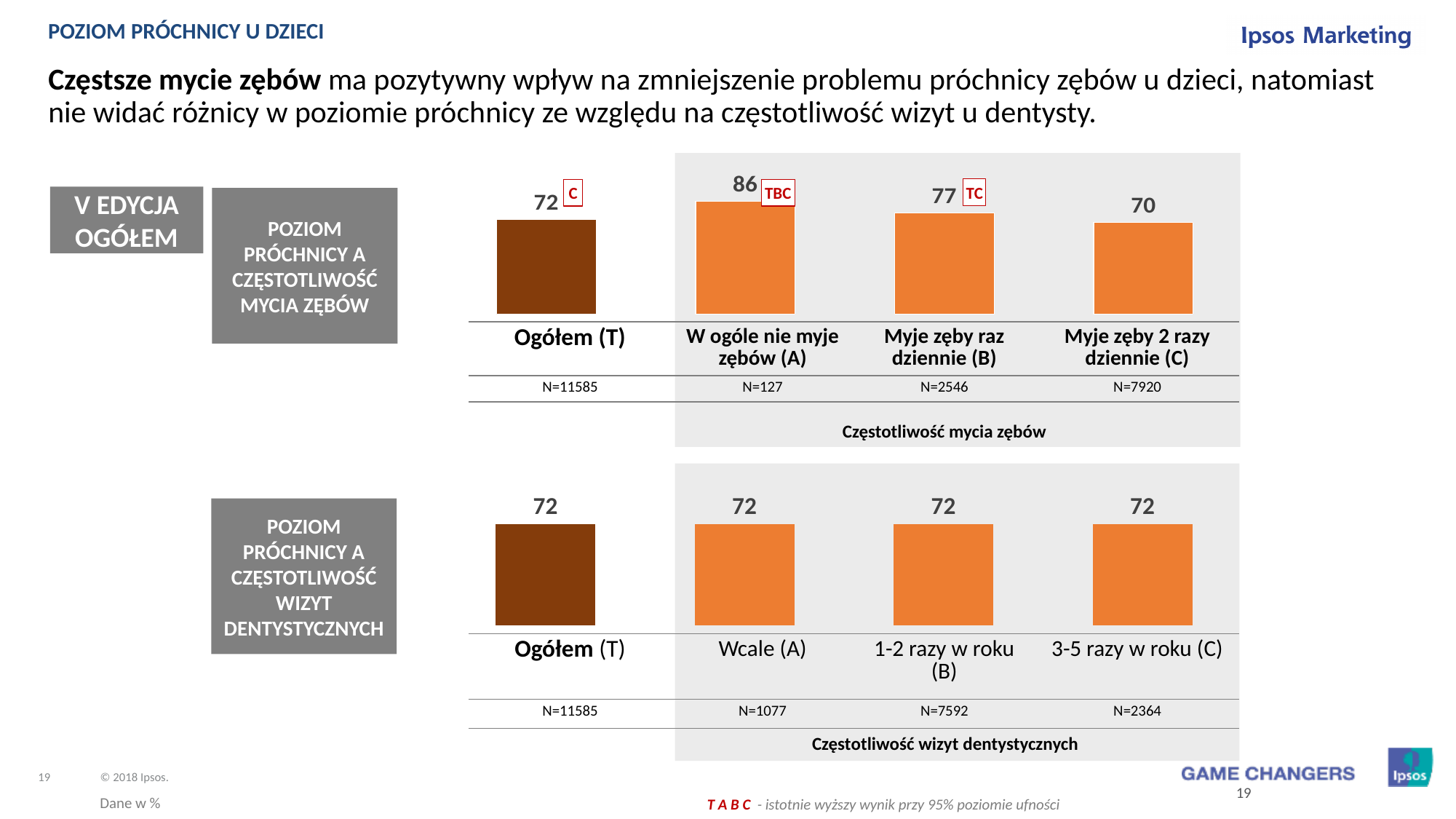
In the top chart (Poziom próchnicy a częstotliwość mycia zębów), which category has the highest value? W ogóle nie myje zębów (A) In the top chart (Poziom próchnicy a częstotliwość mycia zębów), which category has the lowest value? Myje zęby 2 razy dziennie (C) In the top chart (Poziom próchnicy a częstotliwość mycia zębów), which is larger: 'Ogółem (T)' or 'Myje zęby raz dziennie (B)'? Myje zęby raz dziennie (B) In the bottom chart (Poziom próchnicy a częstotliwość wizyt dentystycznych), what is the value for '3-5 razy w roku (C)'? 72 In the top chart (Poziom próchnicy a częstotliwość mycia zębów), what is the value for 'W ogóle nie myje zębów (A)'? 86 How many bars are shown in the bottom chart (Poziom próchnicy a częstotliwość wizyt dentystycznych)? 4 In the top chart (Poziom próchnicy a częstotliwość mycia zębów), what is the value for 'Myje zęby raz dziennie (B)'? 77 What kind of chart is the top chart (Poziom próchnicy a częstotliwość mycia zębów)? Bar chart In the top chart (Poziom próchnicy a częstotliwość mycia zębów), what is the sample size (N) shown for 'W ogóle nie myje zębów (A)'? N=127 In the top chart (Poziom próchnicy a częstotliwość mycia zębów), what is the value for 'Myje zęby 2 razy dziennie (C)'? 70 In the top chart (Poziom próchnicy a częstotliwość mycia zębów), what is the difference between 'W ogóle nie myje zębów (A)' and 'Myje zęby 2 razy dziennie (C)'? 16 In the bottom chart (Poziom próchnicy a częstotliwość wizyt dentystycznych), what is the value for 'Wcale (A)'? 72